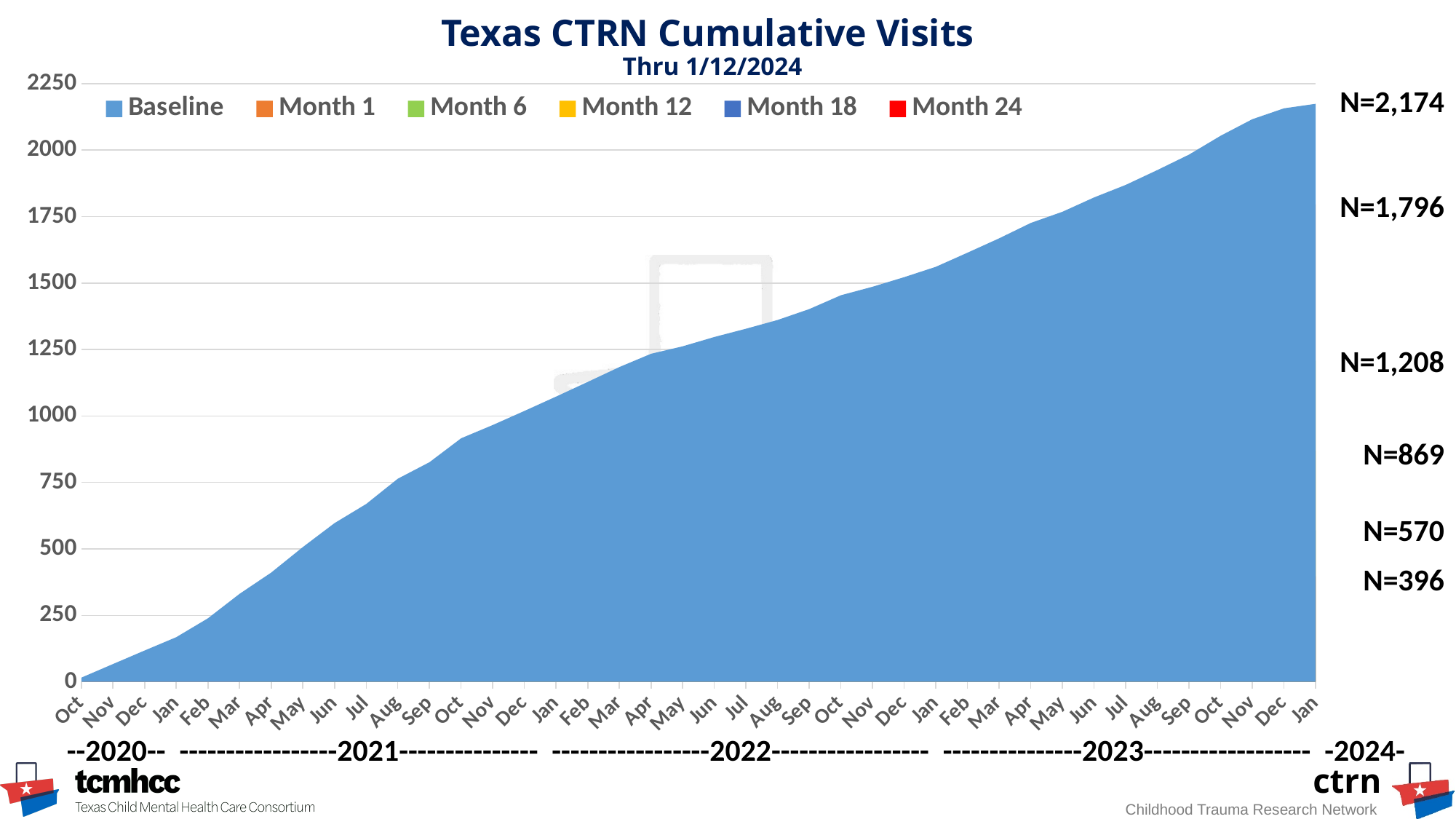
What kind of chart is this? Area chart Do the cumulative visits rise or fall along the x axis from Oct 2020 to Jan 2024? Rise What is the title of the chart? Texas CTRN Cumulative Visits Is the cumulative visits value for Jan 2024 greater or less than 2000? greater Which month has the lowest cumulative visits value? Oct 2020 What is the largest N value printed on the right side of the chart? N=2,174 How many monthly points are shown on the x axis? 40 What date is the chart's data reported through, according to the subtitle? 1/12/2024 Which month has the highest cumulative visits value? Jan 2024 How many series does the legend list? 6 Is the cumulative visits value for Oct 2021 greater or less than 1000? less Is the cumulative visits value for Jan 2023 greater or less than 1500? greater